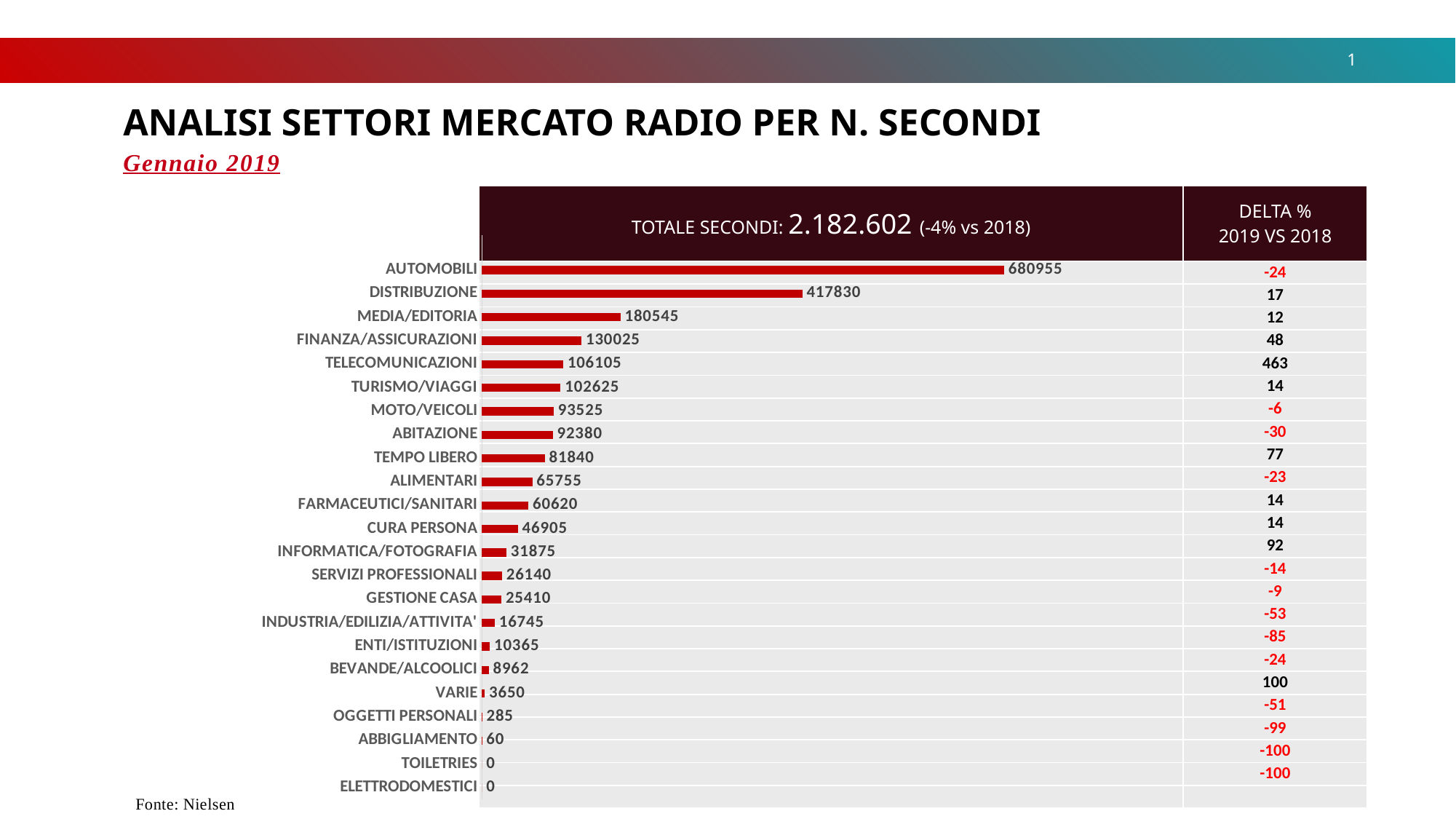
What is the DELTA % 2019 VS 2018 shown for TELECOMUNICAZIONI? 463 How many categories are shown in the chart? 23 What total number of seconds is stated in the chart header? 2.182.602 Which is larger, the value for TURISMO/VIAGGI or the value for ALIMENTARI? TURISMO/VIAGGI What is the difference between the values for MEDIA/EDITORIA and FINANZA/ASSICURAZIONI? 50520 What is the value for CURA PERSONA? 46905 What kind of chart is shown on the slide? bar chart Which category has the highest value? AUTOMOBILI What is the difference between the values for AUTOMOBILI and DISTRIBUZIONE? 263125 What is the value for TELECOMUNICAZIONI? 106105 What is the value for VARIE? 3650 What is the value for AUTOMOBILI? 680955